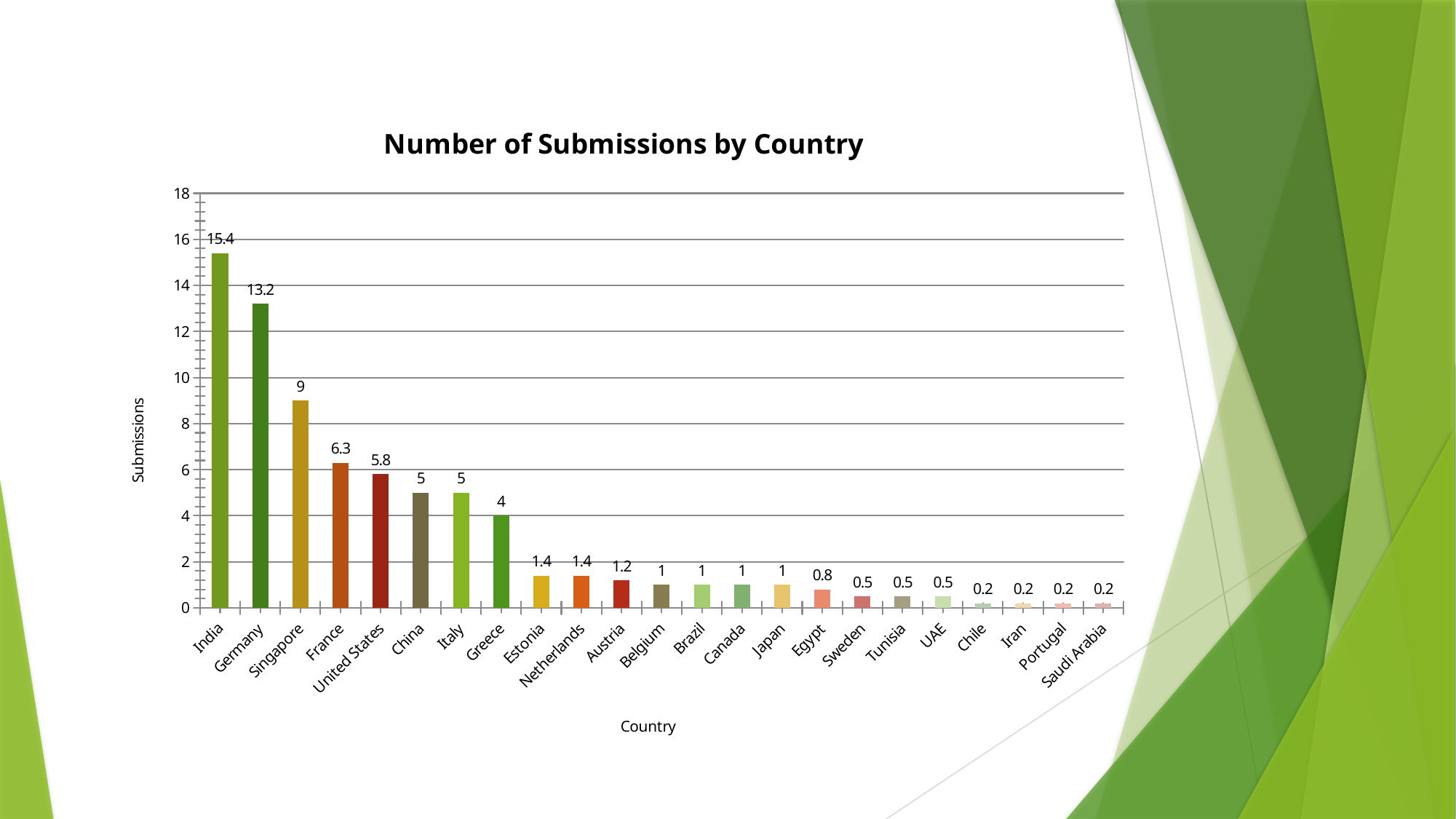
How many countries are shown on the chart? 23 Which has more submissions, Austria or Belgium? Austria What is the number of submissions for Singapore? 9 What is the title of the chart? Number of Submissions by Country What is the number of submissions for India? 15.4 What is the difference in submissions between India and Germany? 2.2 What is the difference in submissions between France and Greece? 2.3 What type of chart is shown on the slide? Bar chart What is the number of submissions for the United States? 5.8 Which has more submissions, Singapore or France? Singapore What is the number of submissions for Egypt? 0.8 Which country has the highest number of submissions? India